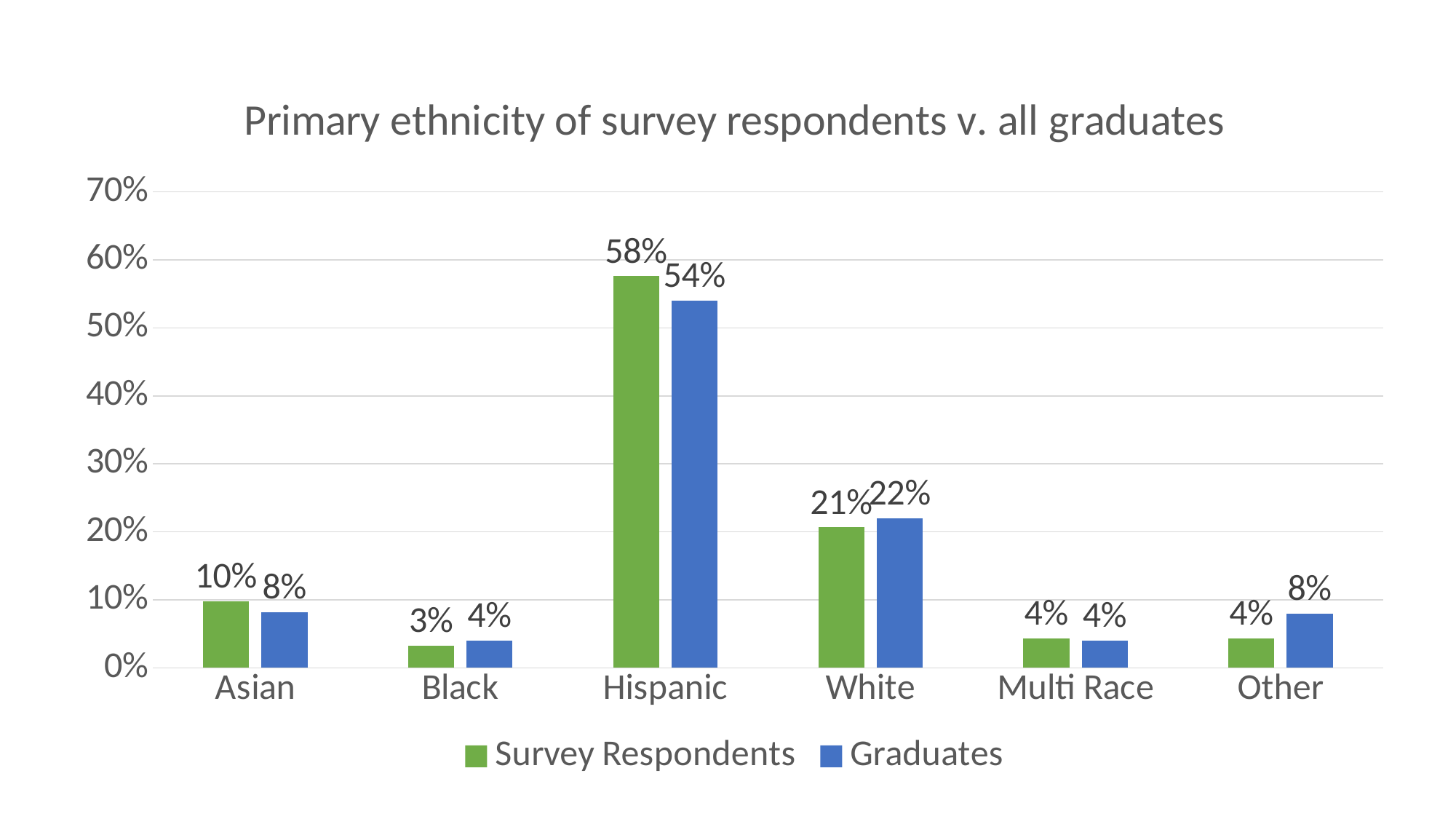
What is the title of the chart? Primary ethnicity of survey respondents v. all graduates What is the Survey Respondents value for Hispanic? 58% How many ethnicity categories are shown on the x axis? 6 What is the Graduates value for Other? 8% Which category has the lowest Survey Respondents value? Black Is the Graduates value for White greater or less than 30%? less What is the Survey Respondents value for Asian? 10% Which category has the highest Graduates value? Hispanic Which is larger for Other: the Survey Respondents value or the Graduates value? Graduates How many series does the legend list? 2 What is the difference between the Survey Respondents and Graduates values for Hispanic? 4% What kind of chart is shown on the slide? bar chart